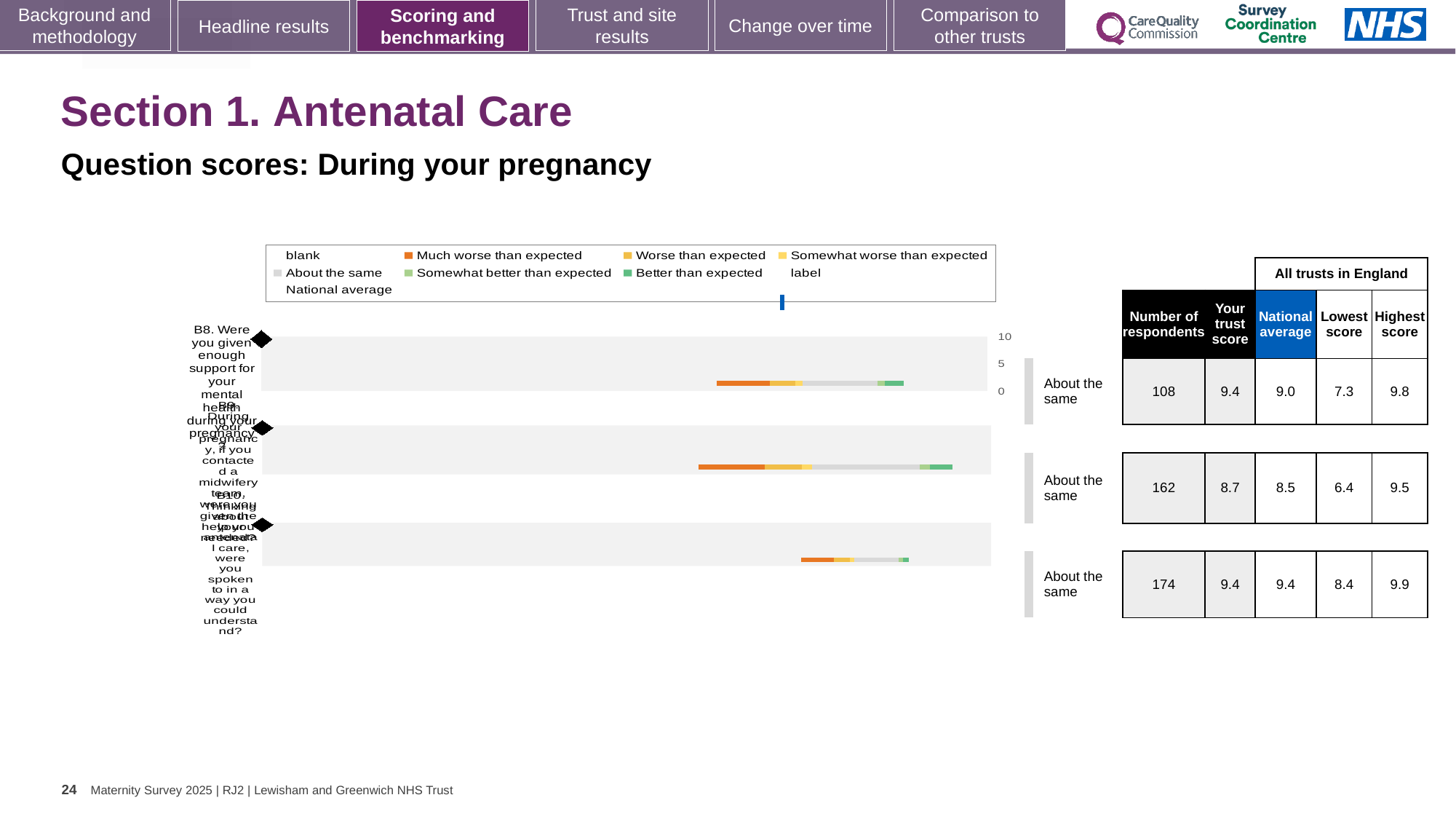
What is the number of respondents for the first row (B8, support for your mental health during pregnancy)? 108 What is the lowest score among all trusts in England for the second row of the table? 6.4 What is the difference between the trust score and the national average in the first row? 0.4 Is the trust score in the second row larger or smaller than its national average? larger What benchmark category is shown for all three rows? About the same What is the highest score among all trusts in England for the third row of the table? 9.9 What is the trust score for the first row (B8, support for your mental health during pregnancy)? 9.4 Which row has the lowest trust score? the second row (8.7) Which row has the highest number of respondents? the third row (174) How many question rows (bars) are plotted in the chart? 3 What is the national average for the second row of the table? 8.5 What kind of chart is shown on the slide? bar chart